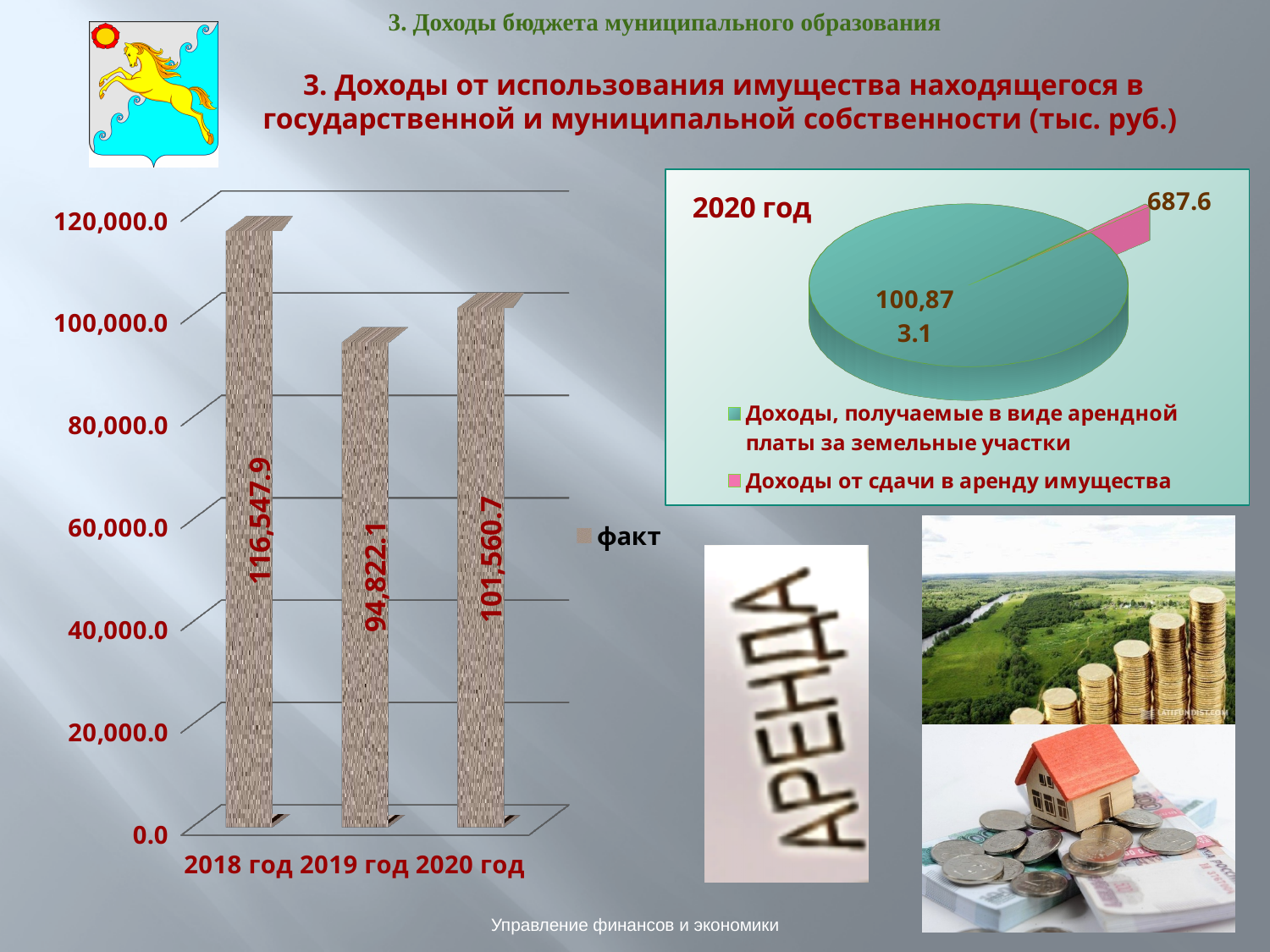
In the bar chart on the left, what is the difference between the values for 2018 год and 2019 год? 21,725.8 In the pie chart titled 2020 год, what is the value for Доходы от сдачи в аренду имущества? 687.6 In the bar chart on the left, does the value rise or fall from 2018 год to 2019 год? fall In the bar chart on the left, what is the value for 2020 год? 101,560.7 What kind of chart is the chart on the left of the slide? bar chart In the bar chart on the left, what is the value for 2018 год? 116,547.9 In the bar chart on the left, what is the value for 2019 год? 94,822.1 In the bar chart on the left, which year has the highest value? 2018 год In the bar chart on the left, how many years are shown on the x axis? 3 In the bar chart on the left, which is larger: the value for 2019 год or for 2020 год? 2020 год In the pie chart titled 2020 год, which category has the larger slice? Доходы, получаемые в виде арендной платы за земельные участки In the bar chart on the left, which year has the lowest value? 2019 год